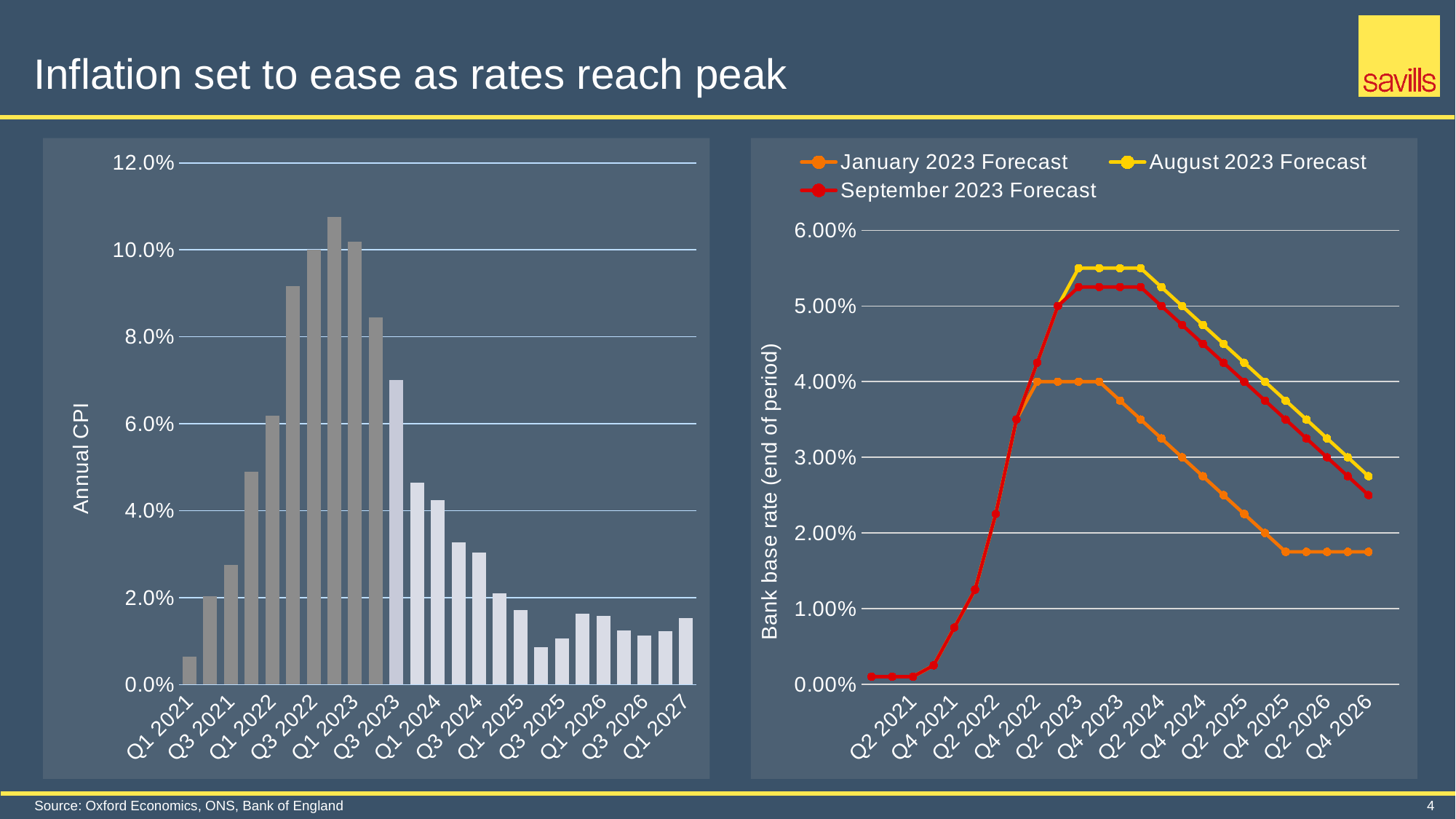
In the left chart, is the Annual CPI value for Q1 2027 greater or less than 2.0%? less In the left chart, which quarter has the lowest Annual CPI bar? Q1 2021 In the right chart, how many series does the legend list? 3 In the left chart, is the Annual CPI value for Q3 2023 greater or less than 6.0%? greater What is the y-axis title of the right chart? Bank base rate (end of period) What kind of chart is the right chart (Bank base rate)? Line chart In the right chart, does the January 2023 Forecast rise or fall between Q2 2024 and Q4 2025? Fall In the right chart, is the August 2023 Forecast value at Q2 2023 greater or less than 5.00%? greater In the right chart, at Q4 2026, which is higher: the August 2023 Forecast or the September 2023 Forecast? August 2023 Forecast What kind of chart is the left chart (Annual CPI)? Bar chart